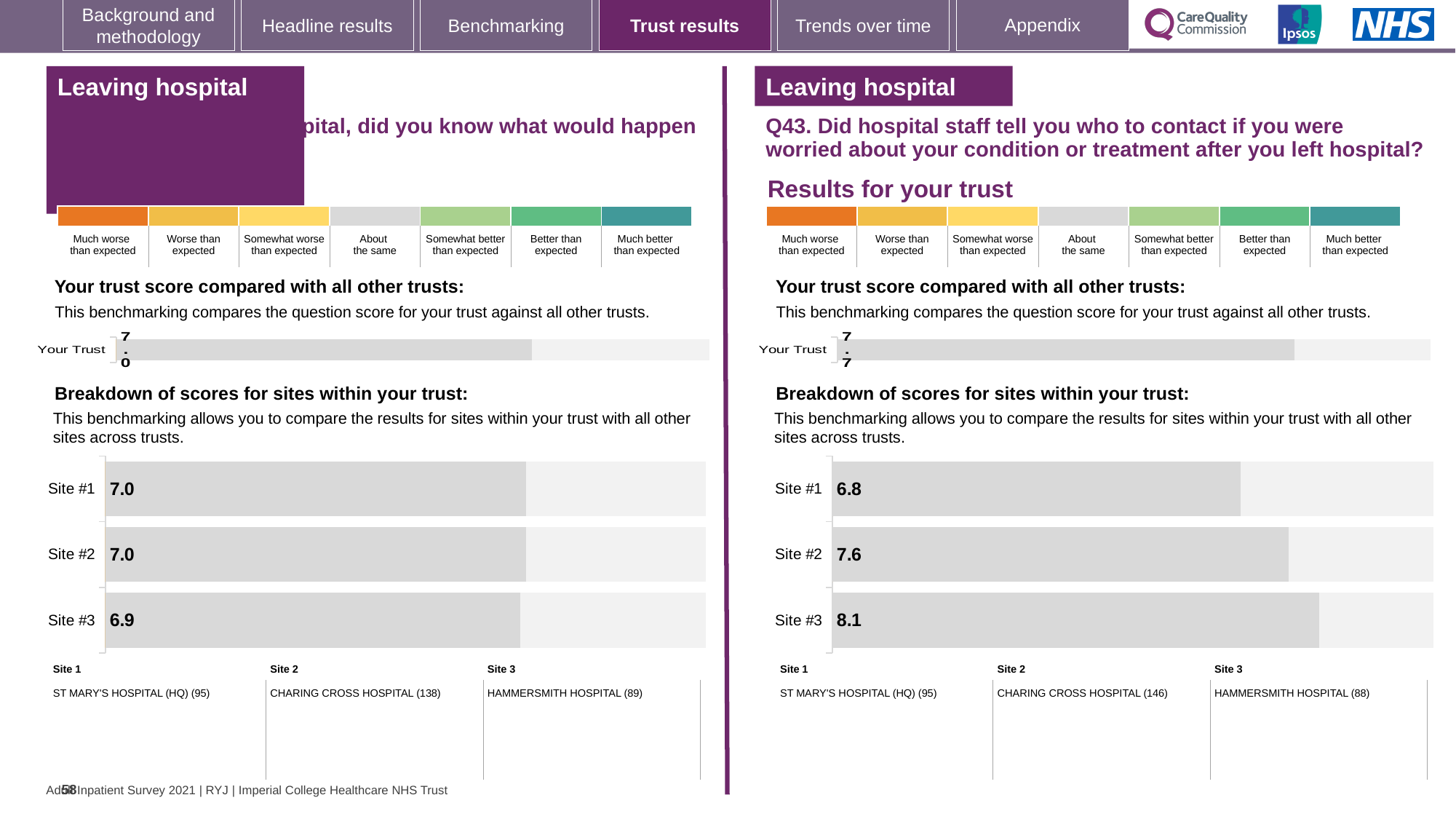
How many sites are shown in the left-hand site breakdown chart? 3 On the right-hand (Q43) site breakdown chart, what is the difference between the scores for Site #3 and Site #1? 1.3 On the right-hand (Q43) site breakdown chart, what is the score for Site #3? 8.1 On the right-hand (Q43) site breakdown chart, which has the larger score, Site #2 or Site #1? Site #2 On the right-hand (Q43) site breakdown chart, which site has the highest score? Site #3 On the left-hand site breakdown chart, what is the score for Site #3? 6.9 On the right-hand (Q43) site breakdown chart, which site has the lowest score? Site #1 On the right-hand (Q43) 'Your Trust' chart, what is the trust score shown? 7.7 On the left-hand site breakdown chart, which site has the lowest score? Site #3 What type of chart is used for the site breakdown on the right-hand (Q43) side? Bar chart On the right-hand (Q43) site breakdown chart, what is the score for Site #1? 6.8 On the left-hand 'Your Trust' chart, what is the trust score shown? 7.0